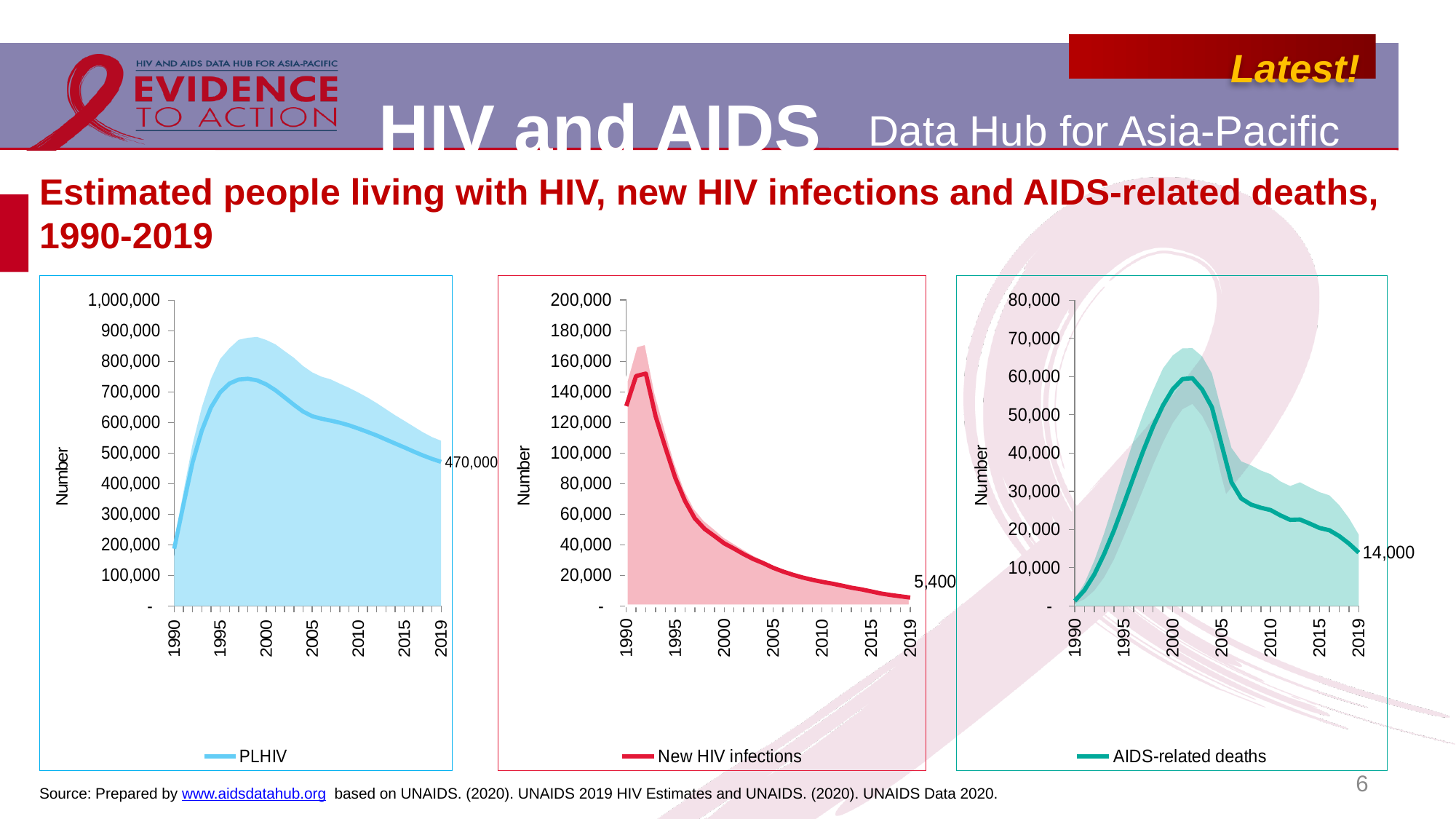
On the left chart (PLHIV), do the values rise or fall from 1990 to 1995? rise On the middle chart (New HIV infections), what is the value shown for 2019? 5,400 On the middle chart (New HIV infections), is the value for 1990 greater or less than 100,000? greater On the right chart (AIDS-related deaths), is the value for 2010 greater or less than 40,000? less What type of chart is the left chart (PLHIV)? combination area and line chart (a line with a shaded area band) On the right chart (AIDS-related deaths), which year has the higher value, 2000 or 2015? 2000 On the middle chart (New HIV infections), do the values rise or fall from 1995 to 2019? fall On the right chart (AIDS-related deaths), what is the value shown for 2019? 14,000 What is the legend entry of the middle chart? New HIV infections How many series does the legend of the right chart list? 1 On the left chart (PLHIV), what is the value shown for 2019? 470,000 On the left chart (PLHIV), is the value for 1990 greater or less than 300,000? less